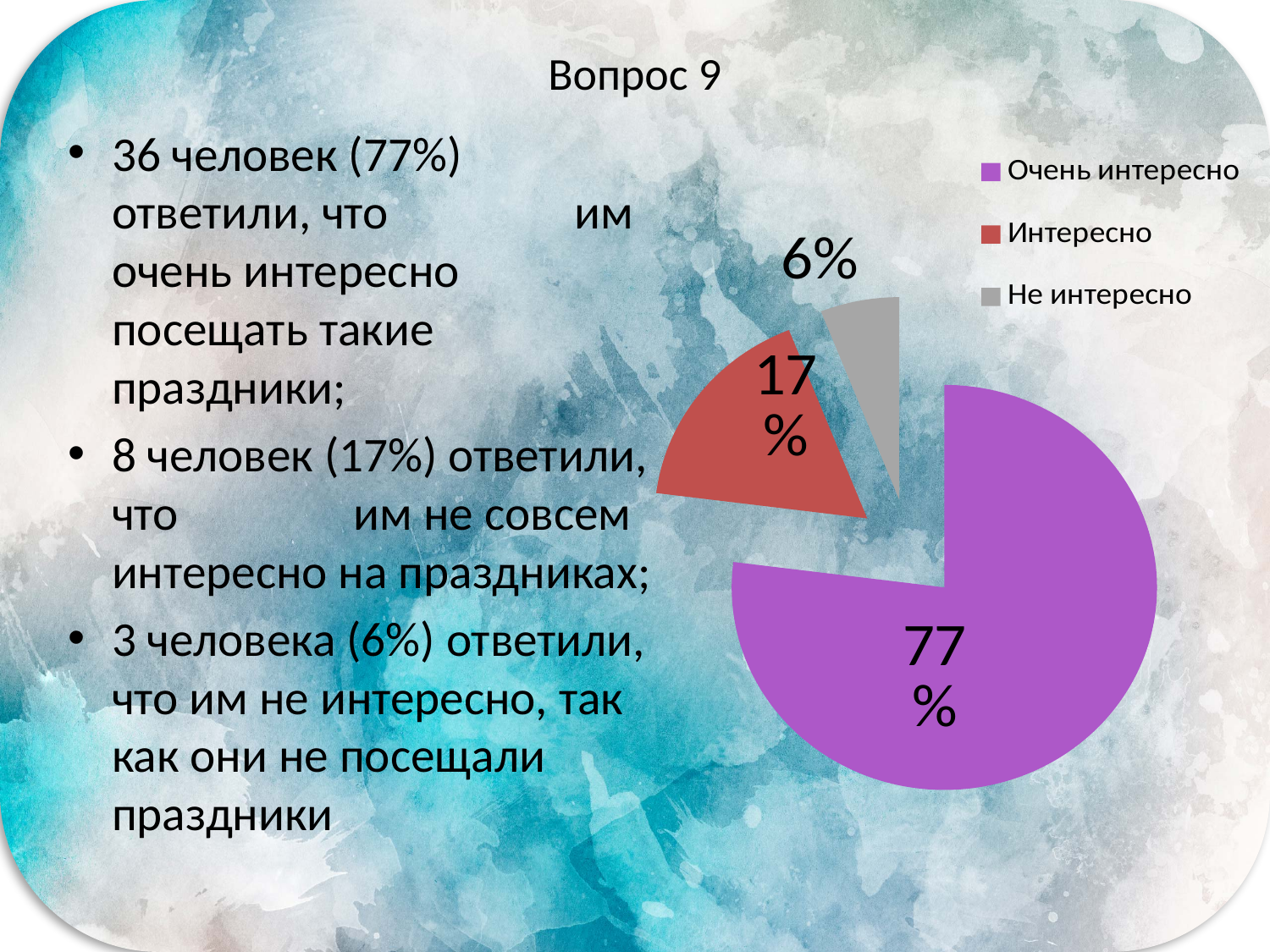
What share of the pie does "Не интересно" take? 6% Which slice is larger, "Интересно" or "Не интересно"? Интересно What kind of chart is shown on the slide? pie chart What colour is the "Не интересно" slice? grey What share of the pie does "Очень интересно" take? 77% What share of the pie does "Интересно" take? 17% Which category has the smallest slice of the pie? Не интересно What is the difference in percentage points between "Очень интересно" and "Интересно"? 60 How many categories does the pie chart show? 3 What colour is the "Очень интересно" slice? purple What is the difference in percentage points between "Интересно" and "Не интересно"? 11 Which category has the largest slice of the pie? Очень интересно